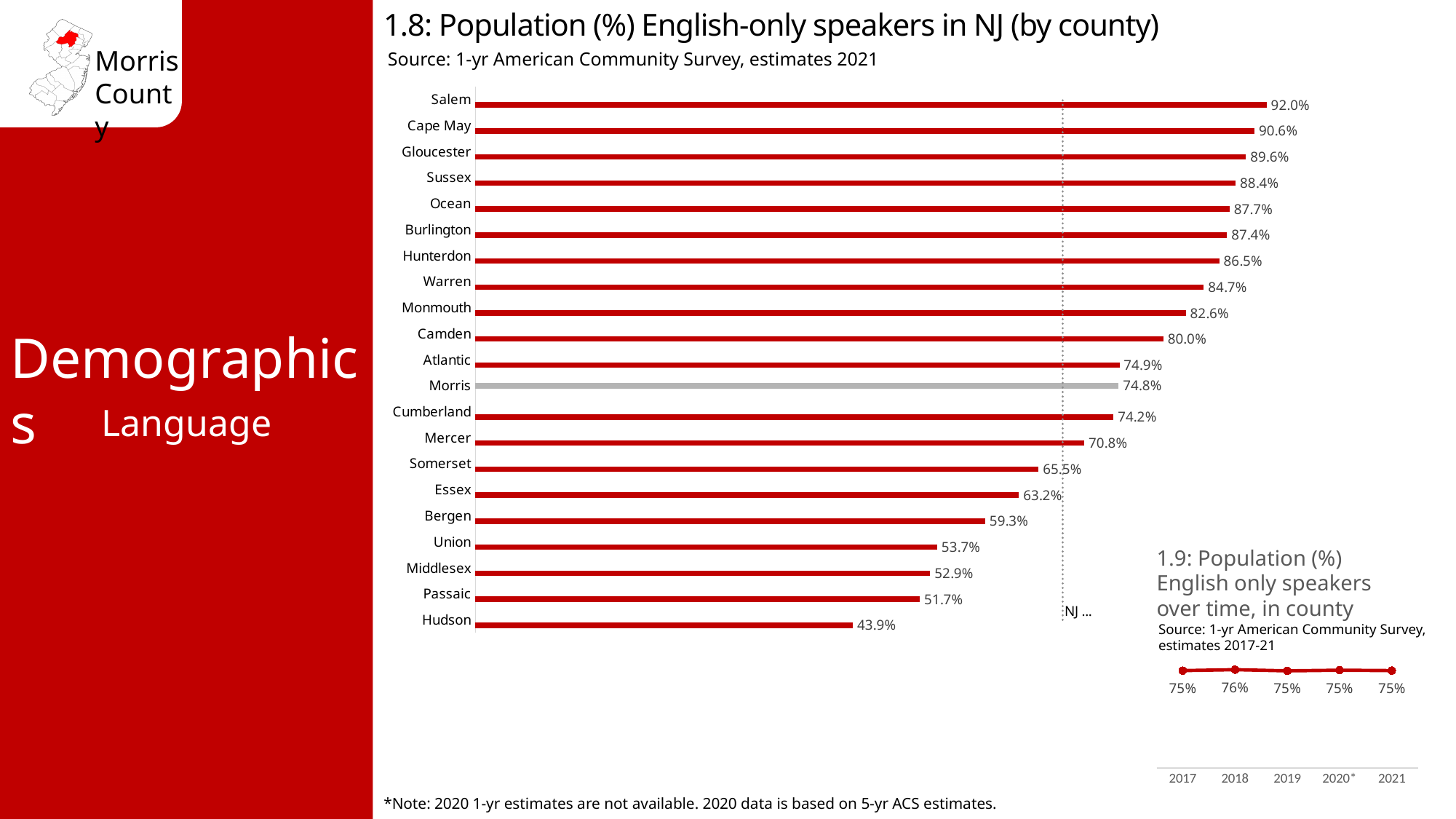
In chart 1.8, how many counties are shown? 21 In chart 1.8, which county has the highest percentage of English-only speakers? Salem In chart 1.8, what is the difference between the values for Salem and Hudson? 48.1% In chart 1.9, how many years are plotted? 5 In chart 1.8, what is the value for Morris? 74.8% In chart 1.8, which is larger, the value for Bergen or the value for Mercer? Mercer What kind of chart is chart 1.8? Bar chart In chart 1.8, what is the value for Hudson? 43.9% In chart 1.8, which county has the lowest percentage of English-only speakers? Hudson In chart 1.8, which county's bar is shown in grey instead of red? Morris What kind of chart is chart 1.9? Line chart In chart 1.9, what is the value for 2018? 76%